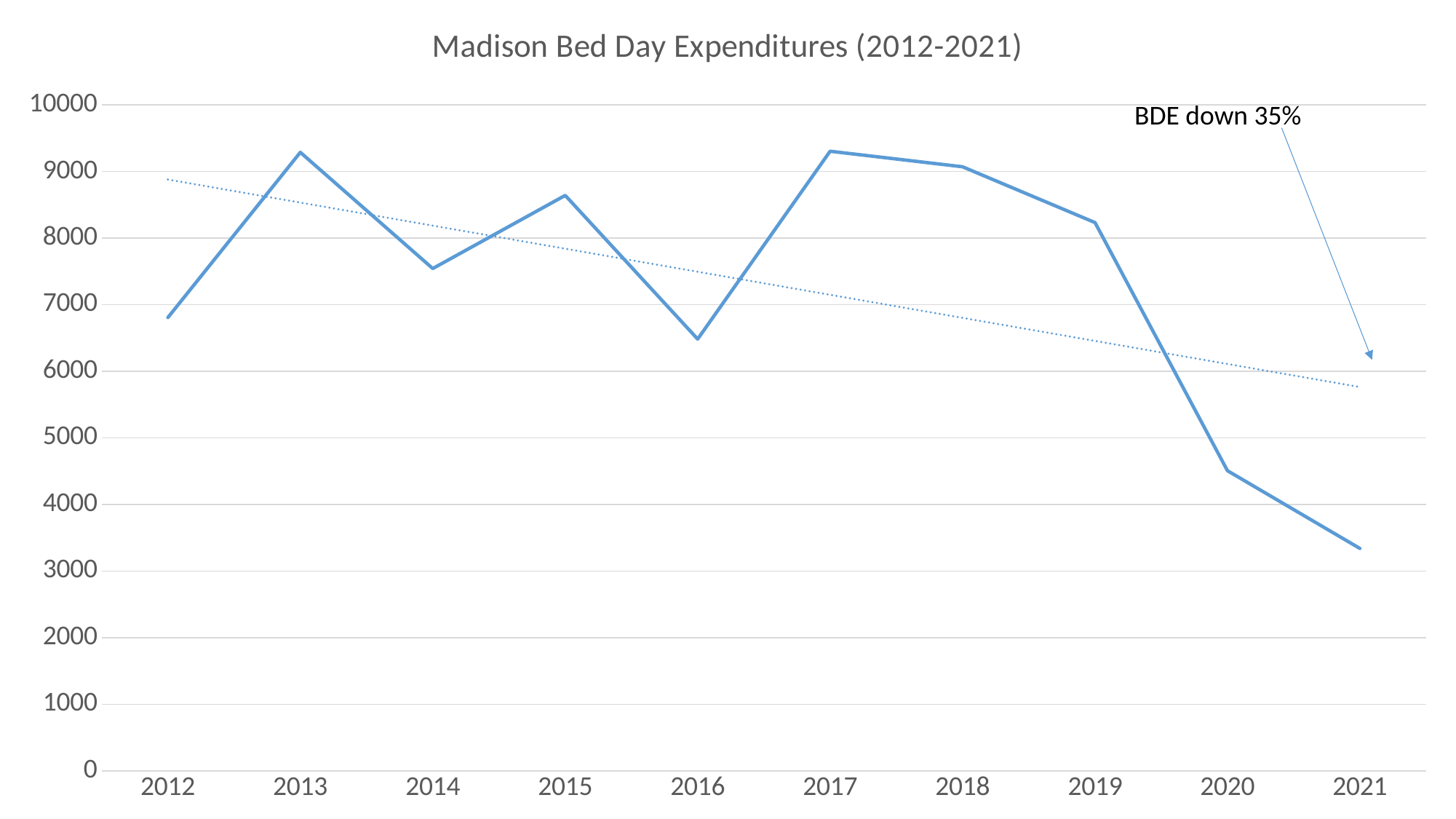
Which year has the higher value, 2014 or 2015? 2015 What does the text annotation with the arrow on the chart say? BDE down 35% Do the values generally rise or fall from 2019 to 2021? fall Is the value for 2021 greater or less than 4000? less What is the title of the chart? Madison Bed Day Expenditures (2012-2021) Is the value for 2020 greater or less than 4000? greater Is the value for 2016 greater or less than 7000? less What kind of chart is shown on the slide? line chart How many years are plotted on the x axis? 10 Which year has the lowest bed day expenditure? 2021